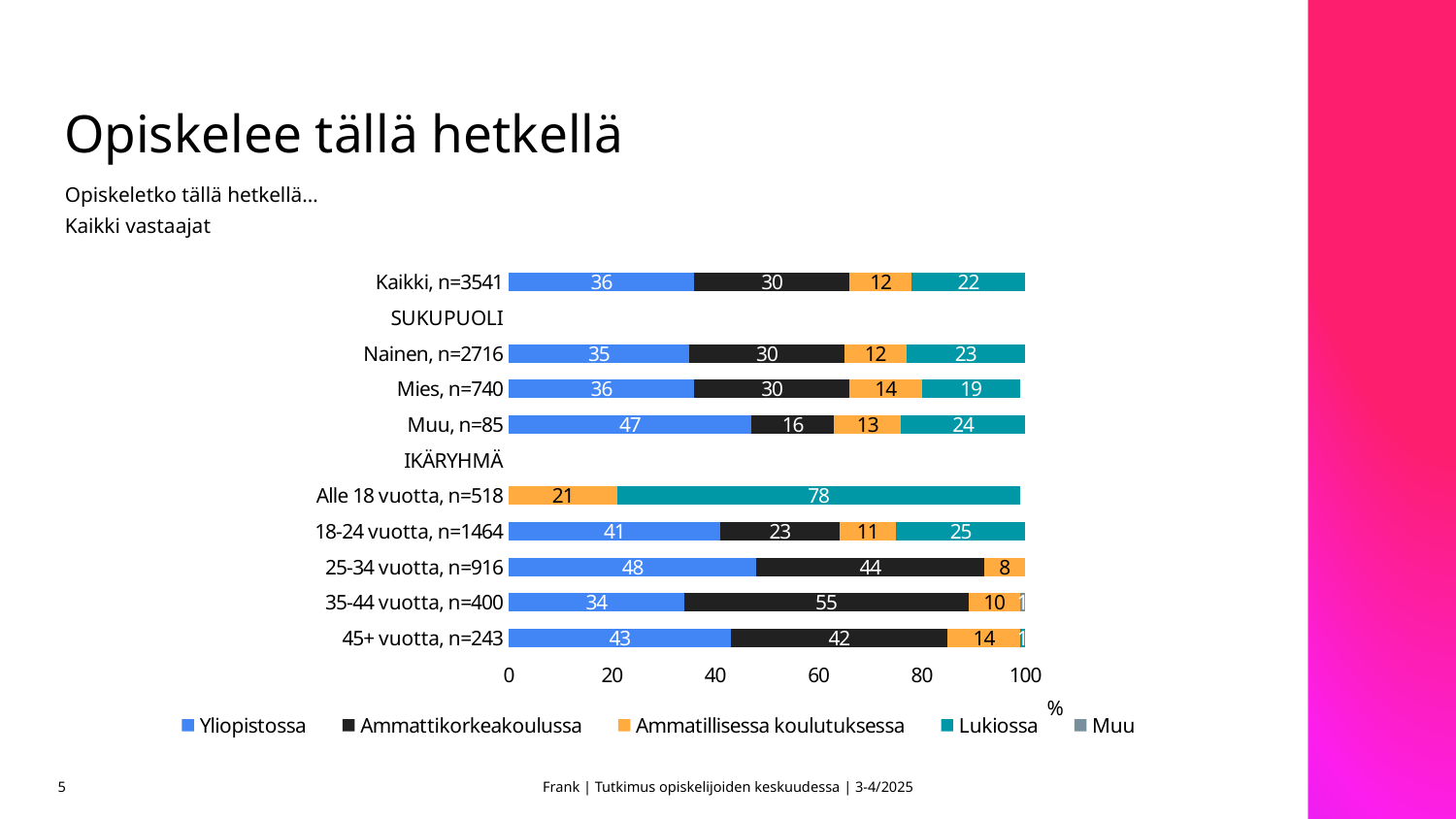
How many series does the legend list? 5 What is the Ammatillisessa koulutuksessa value for Mies, n=740? 14 What is the total of the stacked bar for Kaikki, n=3541? 100 Which is larger: the Yliopistossa value for Muu, n=85 or for Nainen, n=2716? Muu, n=85 What is the difference between the Ammattikorkeakoulussa values for 35-44 vuotta, n=400 and 18-24 vuotta, n=1464? 32 What is the Ammattikorkeakoulussa value for 35-44 vuotta, n=400? 55 What type of chart is shown on the slide? Stacked bar chart What is the Yliopistossa value for Kaikki, n=3541? 36 What is the label of the last series in the legend? Muu Which category has the highest Lukiossa value? Alle 18 vuotta, n=518 What is the Lukiossa value for Alle 18 vuotta, n=518? 78 Which category has the highest Yliopistossa value? 25-34 vuotta, n=916